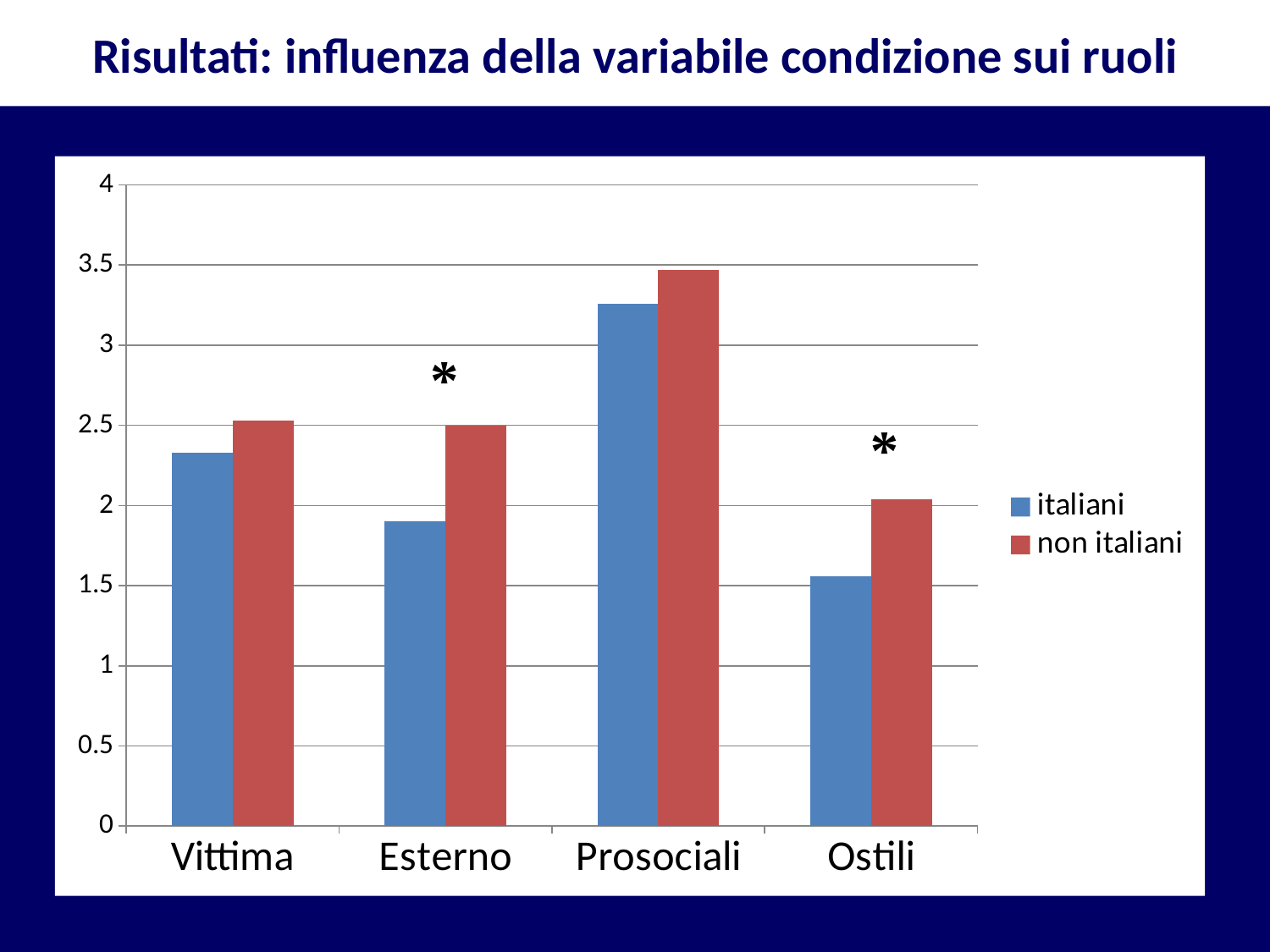
Which category has the lowest value for the italiani series? Ostili How many categories are shown on the x axis of the chart? 4 Which category has the lowest value for the non italiani series? Ostili Is the value for Ostili in the italiani series greater or less than 2? less Is the value for Prosociali in the italiani series greater or less than 3? greater Which category has the highest value for the italiani series? Prosociali For Esterno, which series has the larger value, italiani or non italiani? non italiani How many series does the chart's legend list? 2 What kind of chart is shown on the slide? bar chart For the italiani series, which is larger, Vittima or Esterno? Vittima What are the two series names listed in the chart's legend? italiani, non italiani Is the value for Vittima in the italiani series greater or less than 2? greater